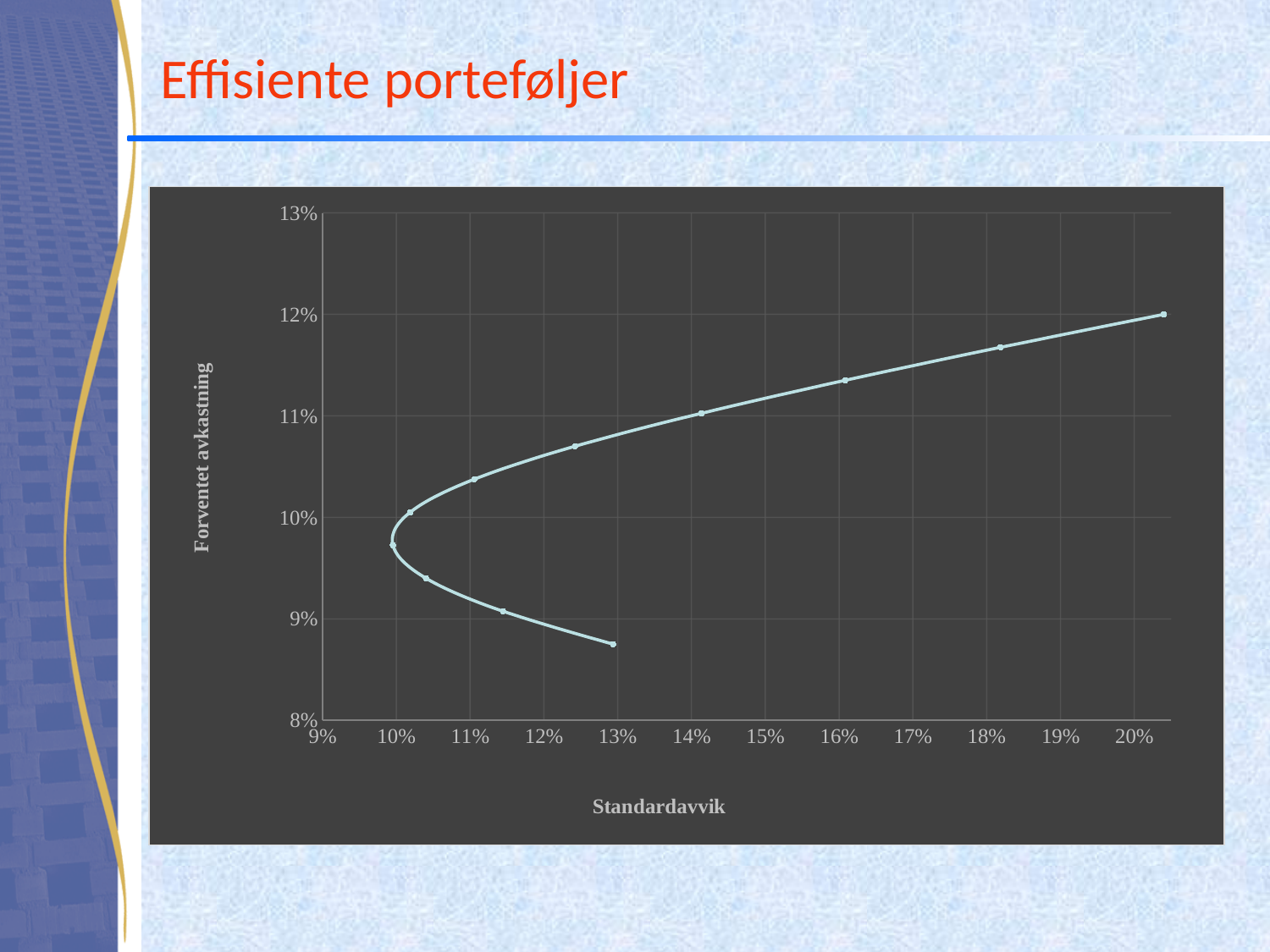
Is the lowest expected return on the curve greater or less than 9%? less What kind of chart is shown on the slide? scatter chart with a smooth line Is the largest standard deviation plotted greater or less than 19%? greater How many data points are plotted on the curve? 11 Along the upper branch of the curve, does expected return rise or fall as standard deviation increases? rise What is the expected return (Forventet avkastning) of the point with the largest standard deviation? 12% Is the highest expected return on the curve greater or less than 11%? greater What is the title of the vertical axis? Forventet avkastning What is the title of the horizontal axis? Standardavvik Along the lower branch of the curve, does expected return rise or fall as standard deviation increases? fall